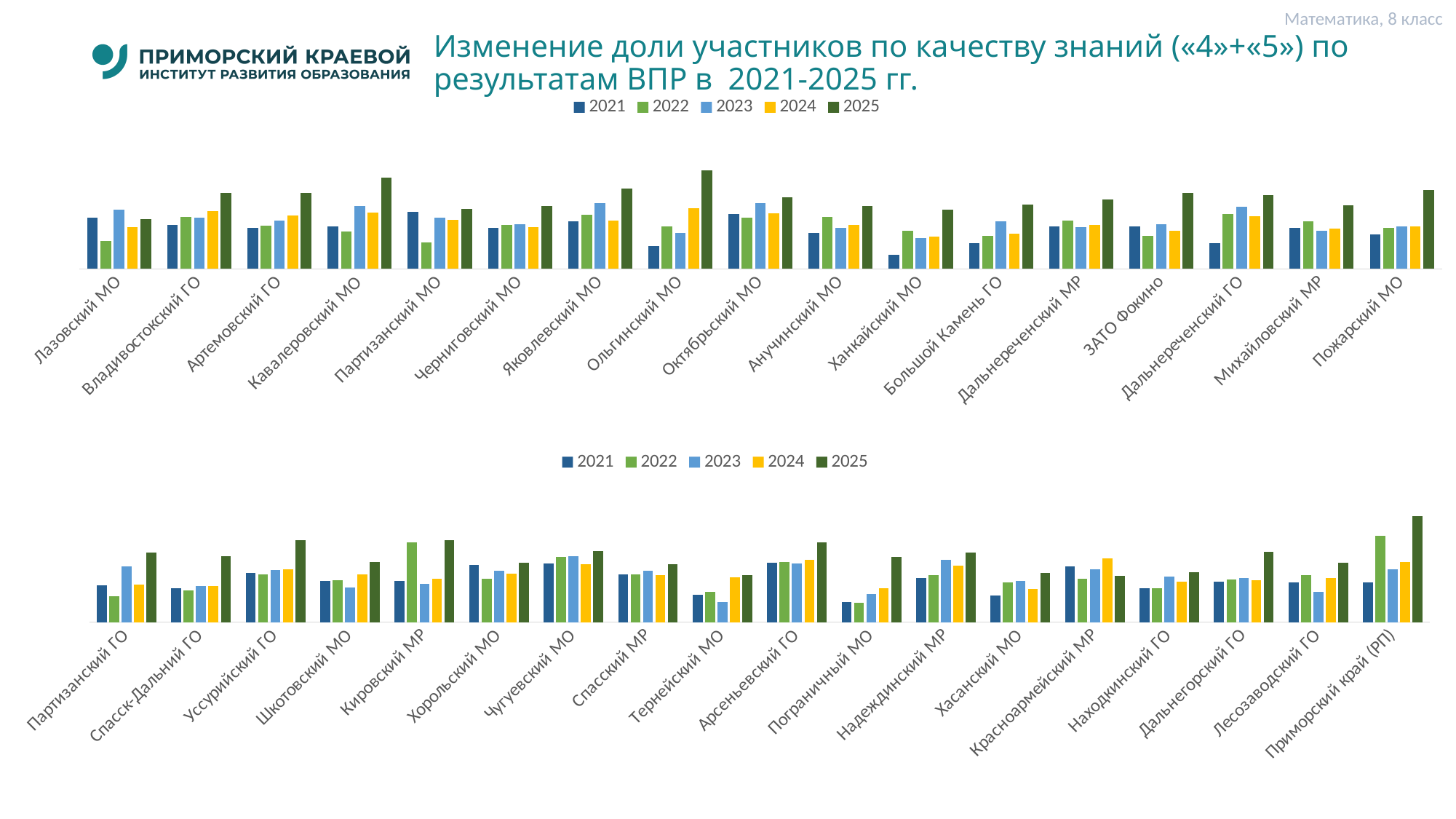
In the bottom chart, for Приморский край (РП), which is larger: the 2021 bar or the 2025 bar? 2025 Which years are listed in the legend of the bottom chart? 2021, 2022, 2023, 2024, 2025 How many series does the legend of the top chart list? 5 In the bottom chart, which category has the tallest 2025 bar? Приморский край (РП) In the top chart, which category has the shortest 2021 bar? Ханкайский МО In the top chart, which category has the tallest 2025 bar? Ольгинский МО What kind of chart is the top chart on the slide? bar chart How many categories are shown on the x axis of the bottom chart? 18 How many categories are shown on the x axis of the top chart? 17 In the bottom chart, for Кировский МР, which is larger: the 2022 bar or the 2023 bar? 2022 What colour represents the 2024 series in the charts? yellow In the top chart, for Лазовский МО, which is larger: the 2022 bar or the 2023 bar? 2023